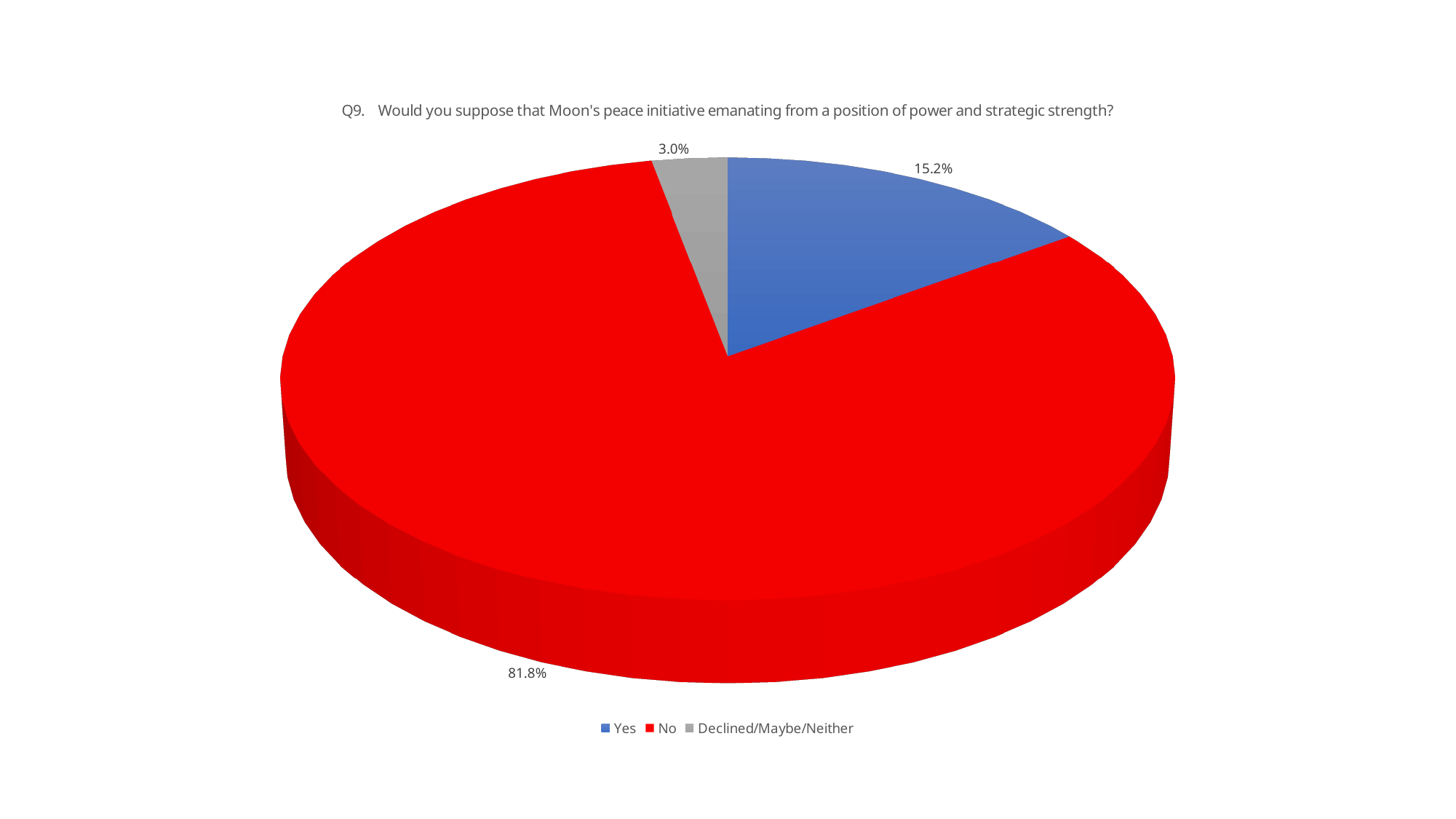
Which response has the largest share of the pie? No How many slices does the pie chart have? 3 What is the title of the chart? Q9. Would you suppose that Moon's peace initiative emanating from a position of power and strategic strength? Which is larger, the "Yes" slice or the "Declined/Maybe/Neither" slice? Yes What percentage of respondents answered "Yes"? 15.2% What share of the pie does the "Yes" slice represent? 15.2% What percentage is shown for "Declined/Maybe/Neither"? 3.0% What is the difference in percentage points between the "No" and "Yes" slices? 66.6 What percentage of respondents answered "No"? 81.8% What colour is the "No" slice? Red Which response has the smallest share of the pie? Declined/Maybe/Neither What kind of chart is shown on the slide? Pie chart